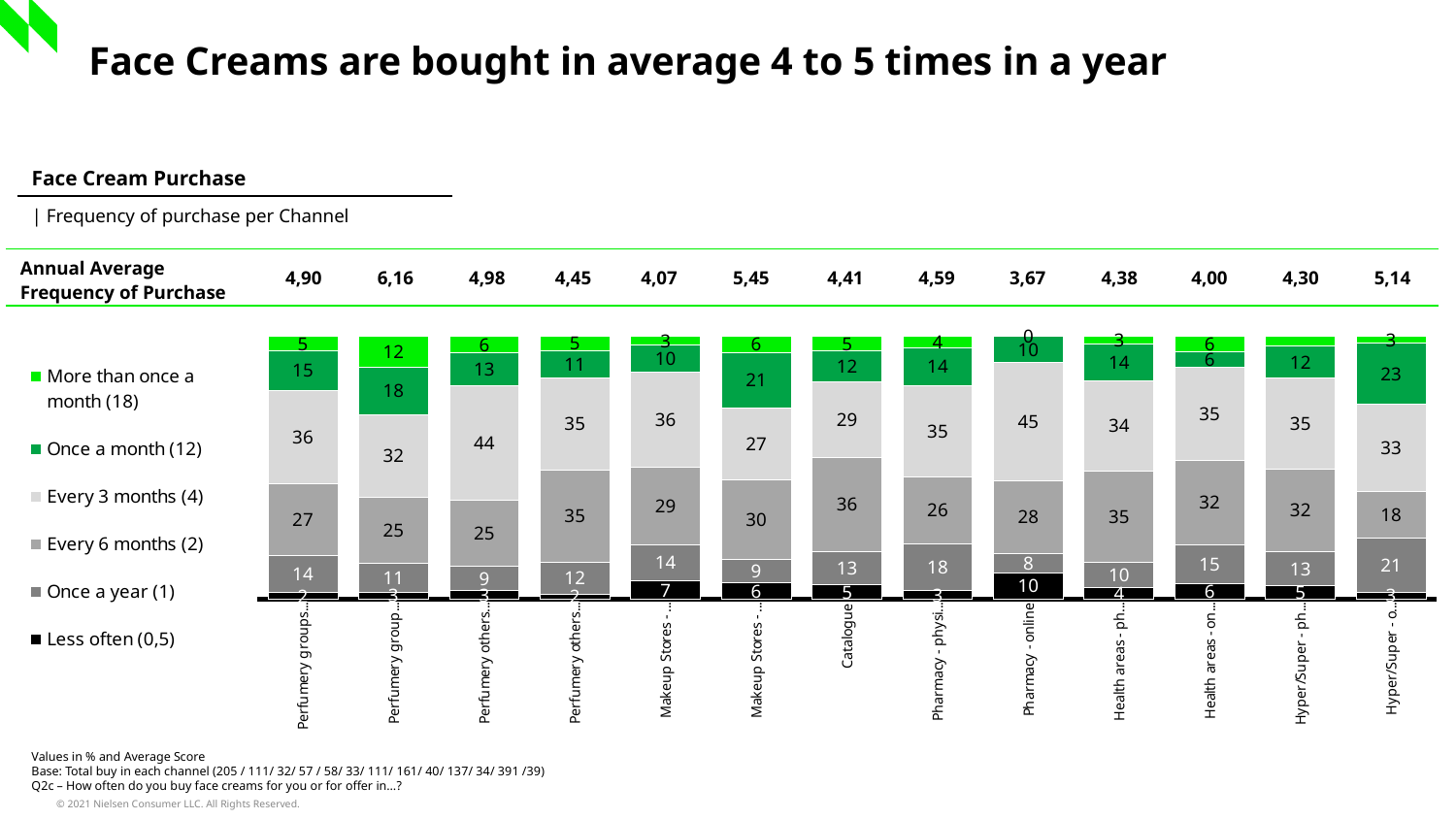
How many channel bars are plotted in the chart? 13 How many series does the legend list? 6 What is the Annual Average Frequency of Purchase shown for Catalogue? 4,41 Which segment is the largest in the Pharmacy - online bar? Every 3 months (4) What is the value for 'Every 6 months (2)' in the Pharmacy - online bar? 28 In the Catalogue bar, which is larger: 'Every 6 months (2)' or 'Every 3 months (4)'? Every 6 months (2) What kind of chart is shown on the slide? Stacked bar chart What is the value for 'Every 6 months (2)' in the Catalogue bar? 36 In the Pharmacy - online bar, what is the difference between 'Every 3 months (4)' and 'Every 6 months (2)'? 17 What is the value for 'Every 3 months (4)' in the Pharmacy - online bar? 45 What is the value for 'Once a month (12)' in the Catalogue bar? 12 What is the value for 'Every 3 months (4)' in the Catalogue bar? 29